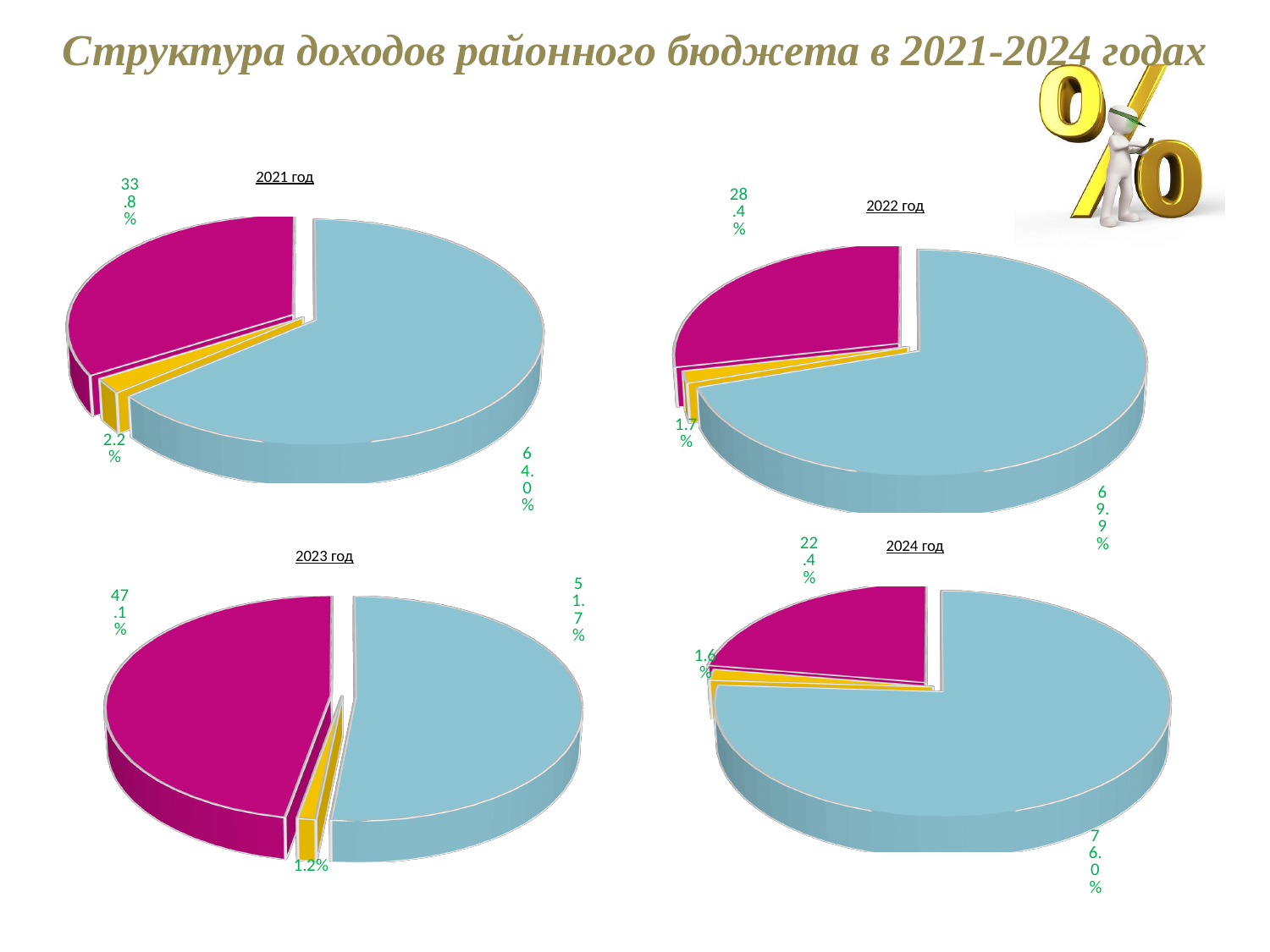
In the 2021 год chart, what is the value of the largest (light blue) slice? 64.0% Which chart has the larger light blue slice, 2023 год or 2024 год? 2024 год In the 2021 год chart, what is the value of the magenta slice? 33.8% In the 2022 год chart, what is the value of the smallest slice? 1.7% What kind of charts are shown on the slide? Pie charts In the 2022 год chart, what is the value of the largest slice? 69.9% How many pie charts are on the slide? 4 In the 2023 год chart, what is the difference between the light blue slice (51.7%) and the magenta slice (47.1%)? 4.6% In the 2024 год chart, what is the value of the largest slice? 76.0% In the 2021 год chart, what is the value of the smallest (yellow) slice? 2.2% In the 2023 год chart, what is the value of the magenta slice? 47.1% How many slices does each pie chart have? 3